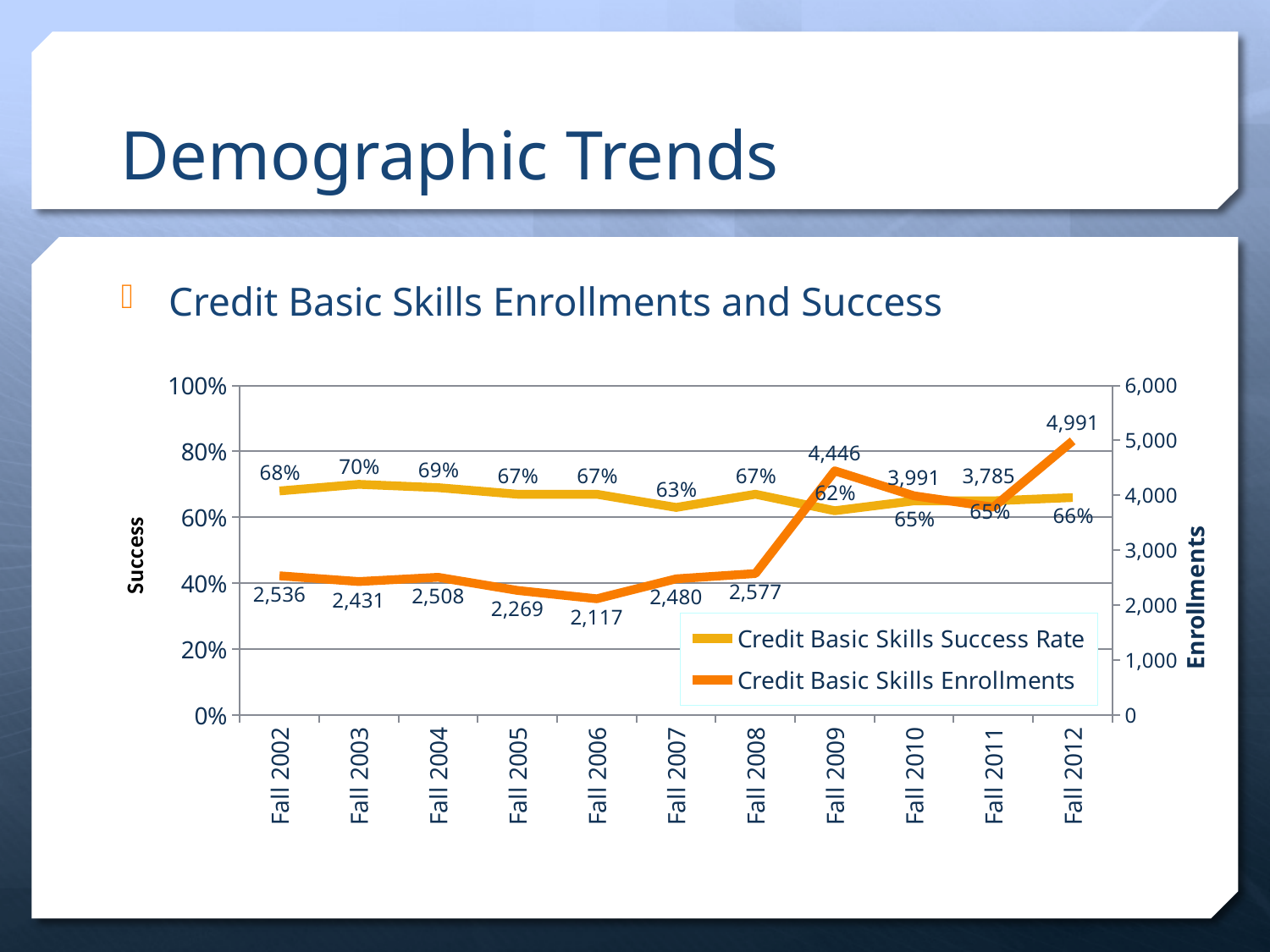
What kind of chart is shown on the slide? Line chart What was the Credit Basic Skills Success Rate in Fall 2003? 70% How many series does the chart's legend list? 2 In which term were Credit Basic Skills Enrollments highest? Fall 2012 In which term was the Credit Basic Skills Success Rate lowest? Fall 2009 What was the Credit Basic Skills Success Rate in Fall 2009? 62% How many Credit Basic Skills Enrollments were there in Fall 2006? 2,117 How many Credit Basic Skills Enrollments were there in Fall 2012? 4,991 How many terms are shown on the x axis of the chart? 11 Which term had more Credit Basic Skills Enrollments, Fall 2010 or Fall 2011? Fall 2010 In which term were Credit Basic Skills Enrollments lowest? Fall 2006 What is the difference in Credit Basic Skills Enrollments between Fall 2009 and Fall 2008? 1,869